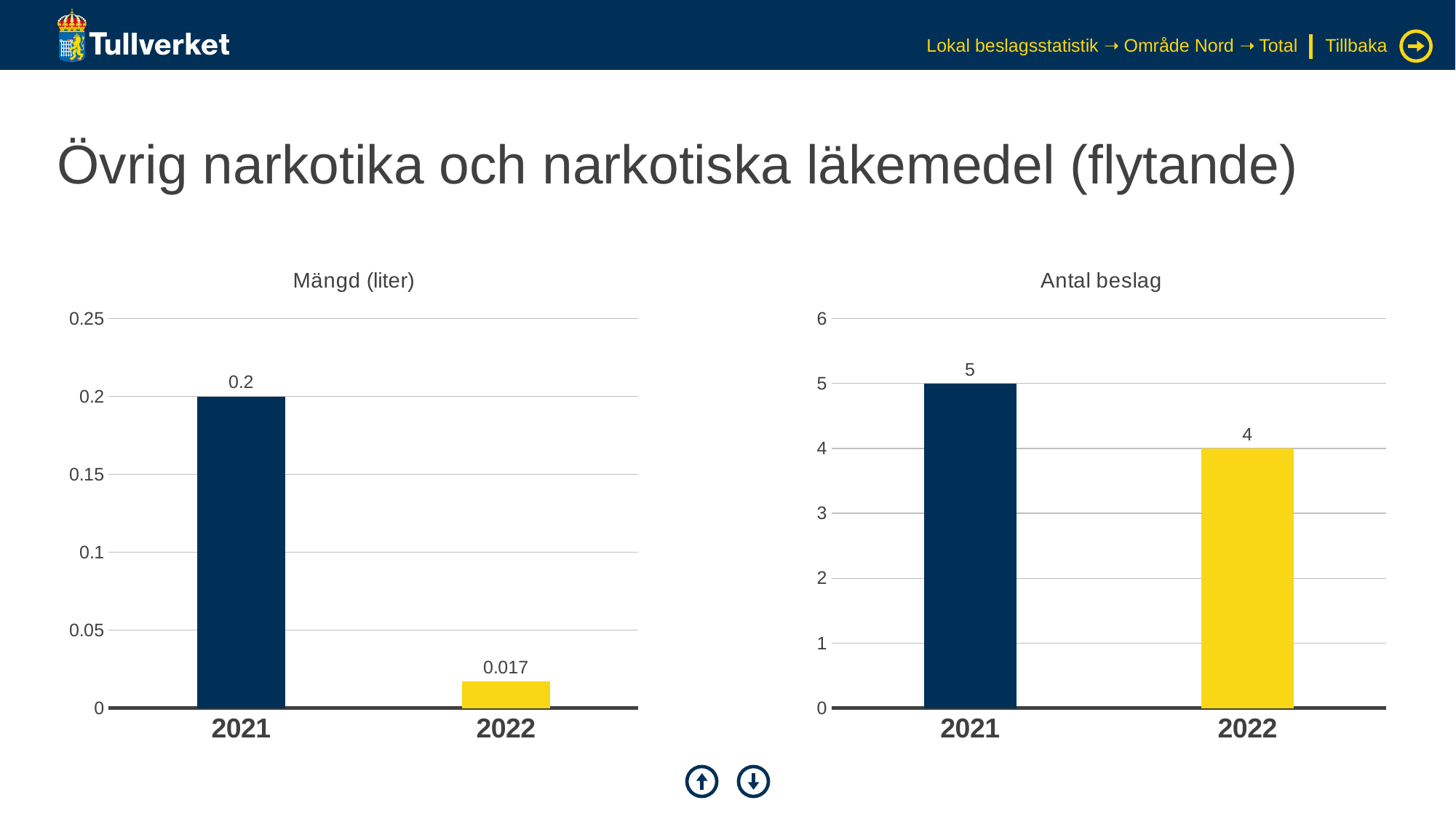
In the 'Antal beslag' chart, what is the value for 2021? 5 In the 'Mängd (liter)' chart, what is the value for 2022? 0.017 How many categories are shown on the x axis of the 'Antal beslag' chart? 2 In the 'Mängd (liter)' chart, which year has the highest value? 2021 In the 'Antal beslag' chart, what is the difference between the values for 2021 and 2022? 1 In the 'Antal beslag' chart, what is the value for 2022? 4 In the 'Mängd (liter)' chart, what is the value for 2021? 0.2 In the 'Mängd (liter)' chart, is the value for 2022 greater or less than 0.05? less In the 'Antal beslag' chart, do the values rise or fall from 2021 to 2022? fall In the 'Mängd (liter)' chart, is the value for 2021 larger or smaller than the value for 2022? larger What kind of chart is the 'Antal beslag' chart? bar chart In the 'Antal beslag' chart, which year has the lowest value? 2022